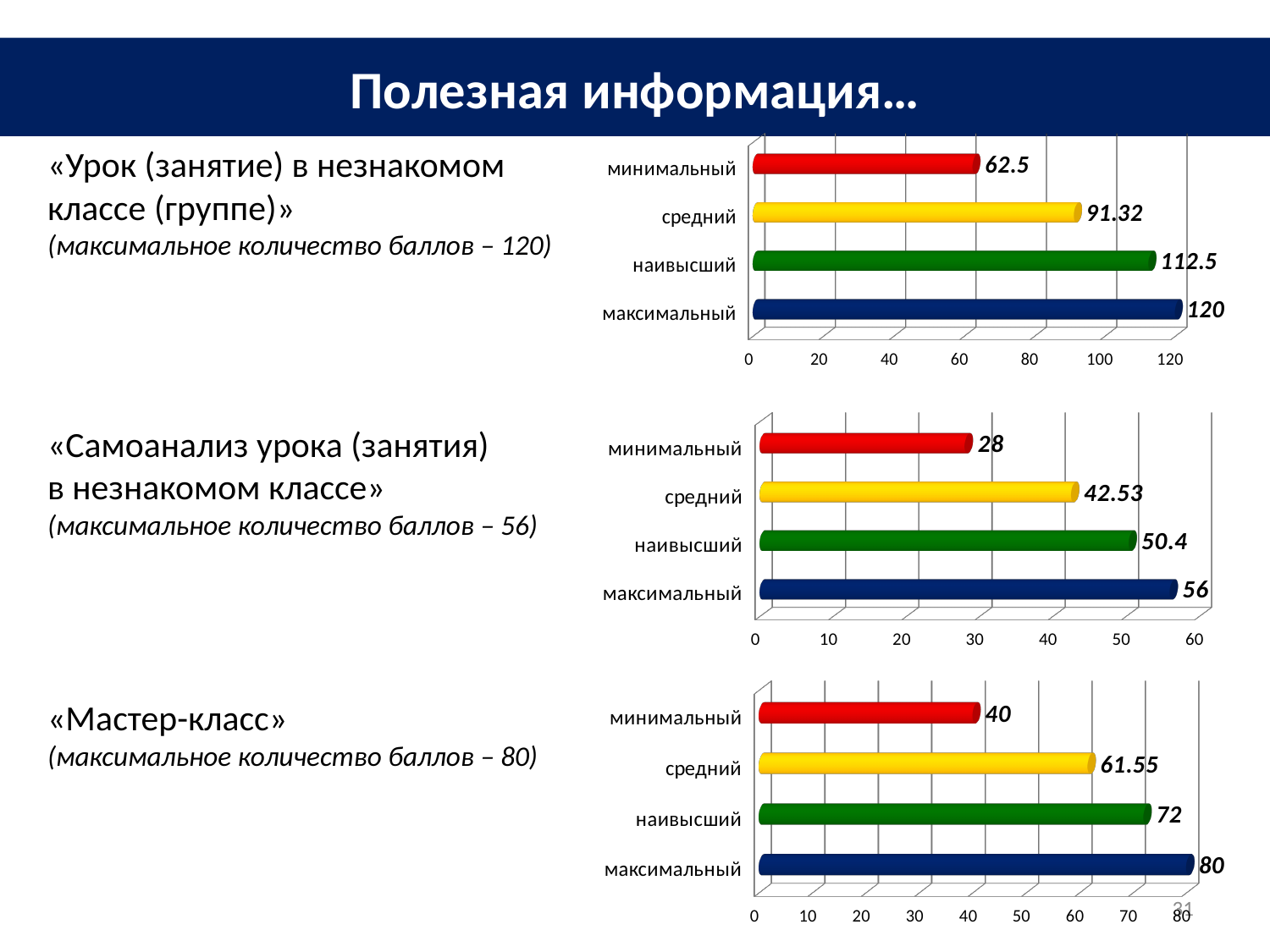
In the middle chart, what is the value for минимальный? 28 In the middle chart, what is the difference between максимальный and наивысший? 5.6 In the top chart, what is the difference between максимальный and минимальный? 57.5 In the top chart, which category has the lowest value? минимальный In the bottom chart, which is larger, наивысший or средний? наивысший In the middle chart, which category has the highest value? максимальный In the bottom chart (next to «Мастер-класс»), what is the value for средний? 61.55 In the middle chart (next to «Самоанализ урока (занятия) в незнакомом классе»), what is the value for средний? 42.53 How many bars does the bottom chart have? 4 In the top chart, what is the value for наивысший? 112.5 In the top chart (next to «Урок (занятие) в незнакомом классе (группе)»), what is the value for средний? 91.32 What type of chart is the top chart? bar chart